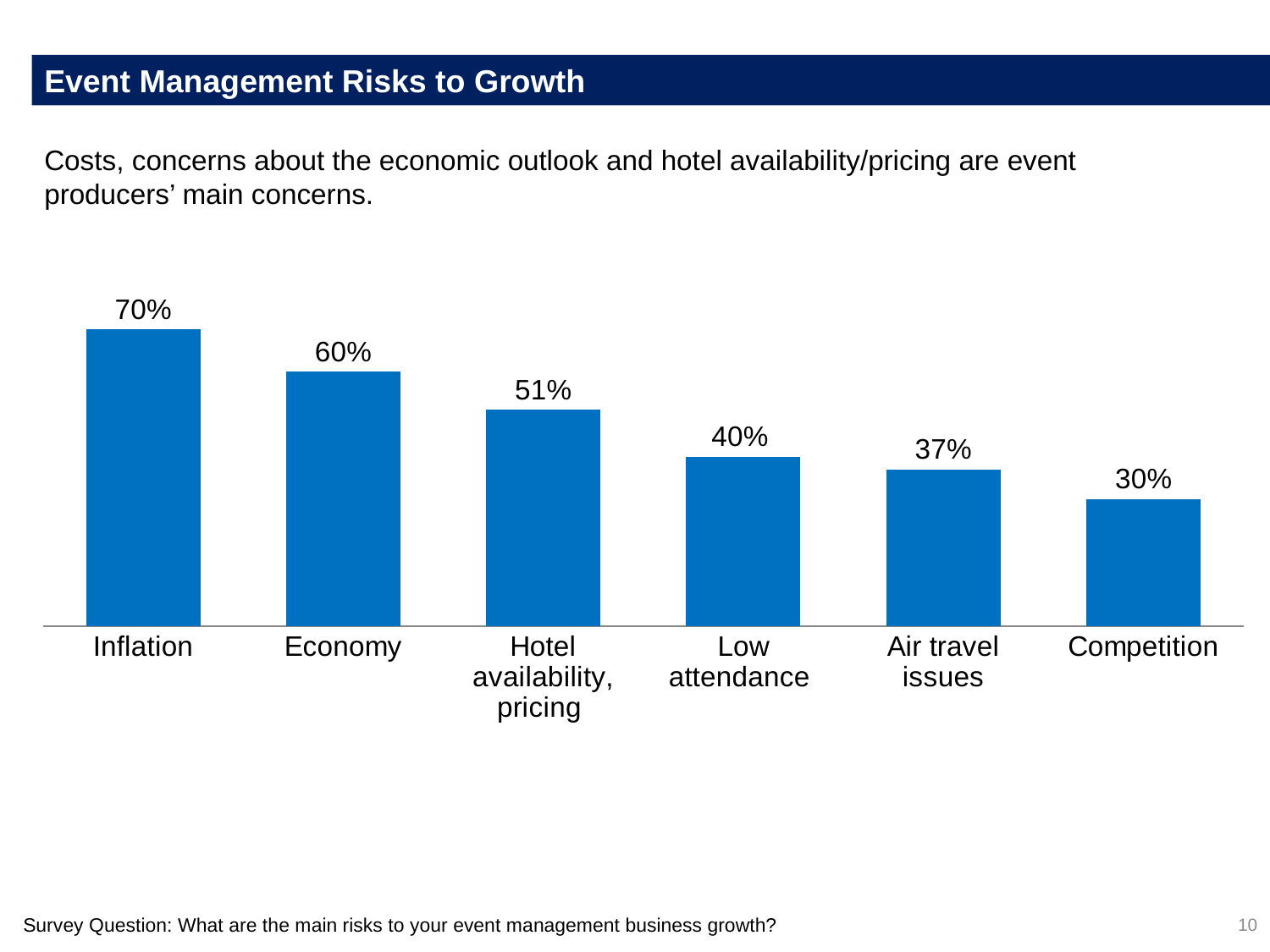
What is the title of the slide containing the chart? Event Management Risks to Growth Which category has the lowest value in the chart? Competition What is the value shown for Air travel issues? 37% What percentage of respondents cited Inflation as a risk to growth? 70% Which category has the highest value in the chart? Inflation Do the values rise or fall from left to right across the chart? Fall How many categories are shown in the chart? 6 Which is larger, the value for Economy or the value for Low attendance? Economy What kind of chart is shown on the slide? Bar chart What is the difference between the values for Inflation and Economy? 10% What is the value shown for Hotel availability, pricing? 51% What is the difference between the values for Low attendance and Competition? 10%